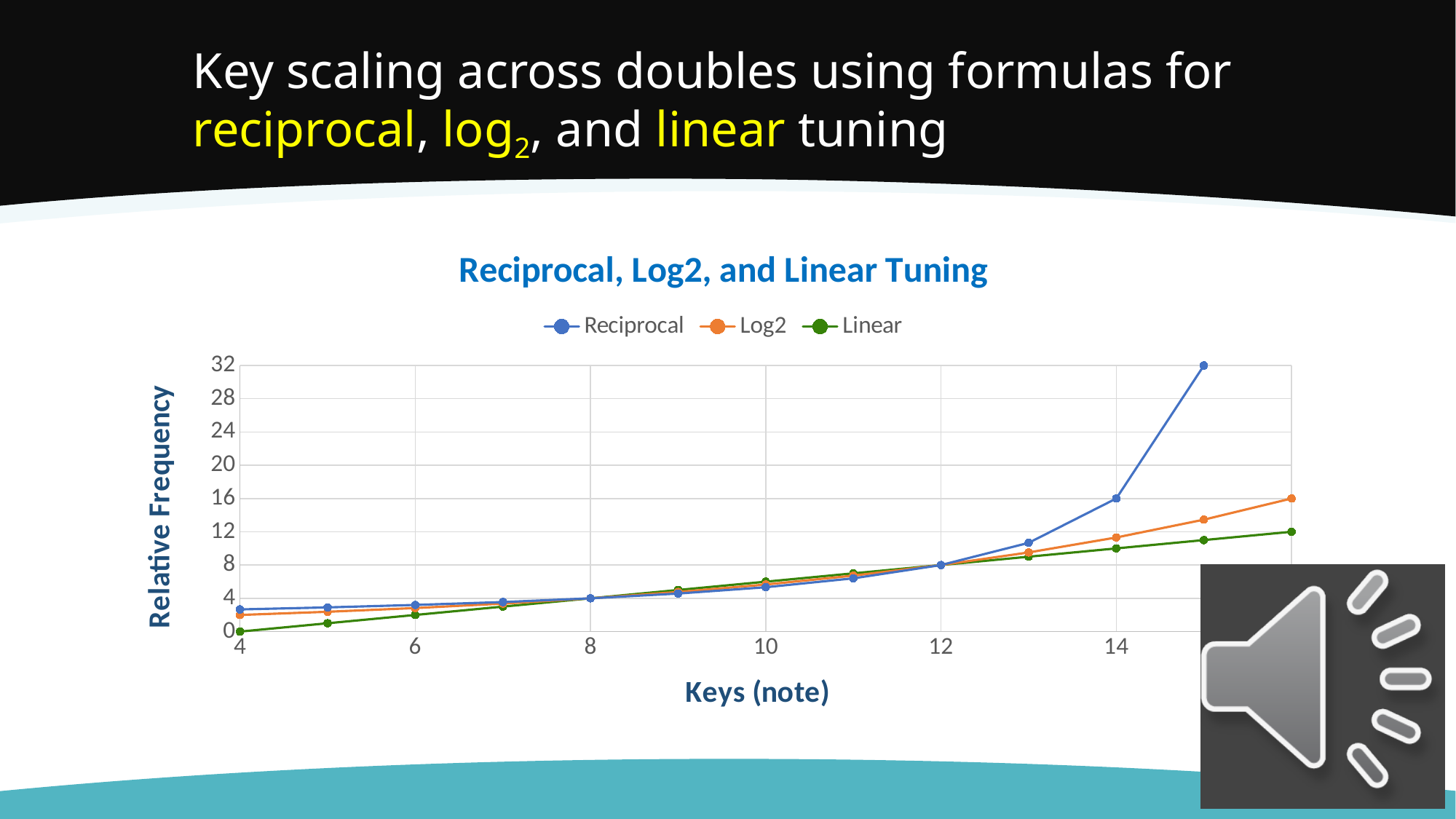
How many series does the legend list? 3 What kind of chart is shown on the slide? line chart Which series has the lowest value at key 4? Linear Is the Reciprocal value at key 13 greater or less than 8? greater What is the difference between the Log2 and Linear values at key 16? 4 Which series has the highest value at key 15? Reciprocal What is the Reciprocal value at key 15? 32 What is the Log2 value at key 16? 16 What is the title of the chart? Reciprocal, Log2, and Linear Tuning What is the label of the vertical axis? Relative Frequency What is the Linear value at key 16? 12 What is the Linear value at key 4? 0